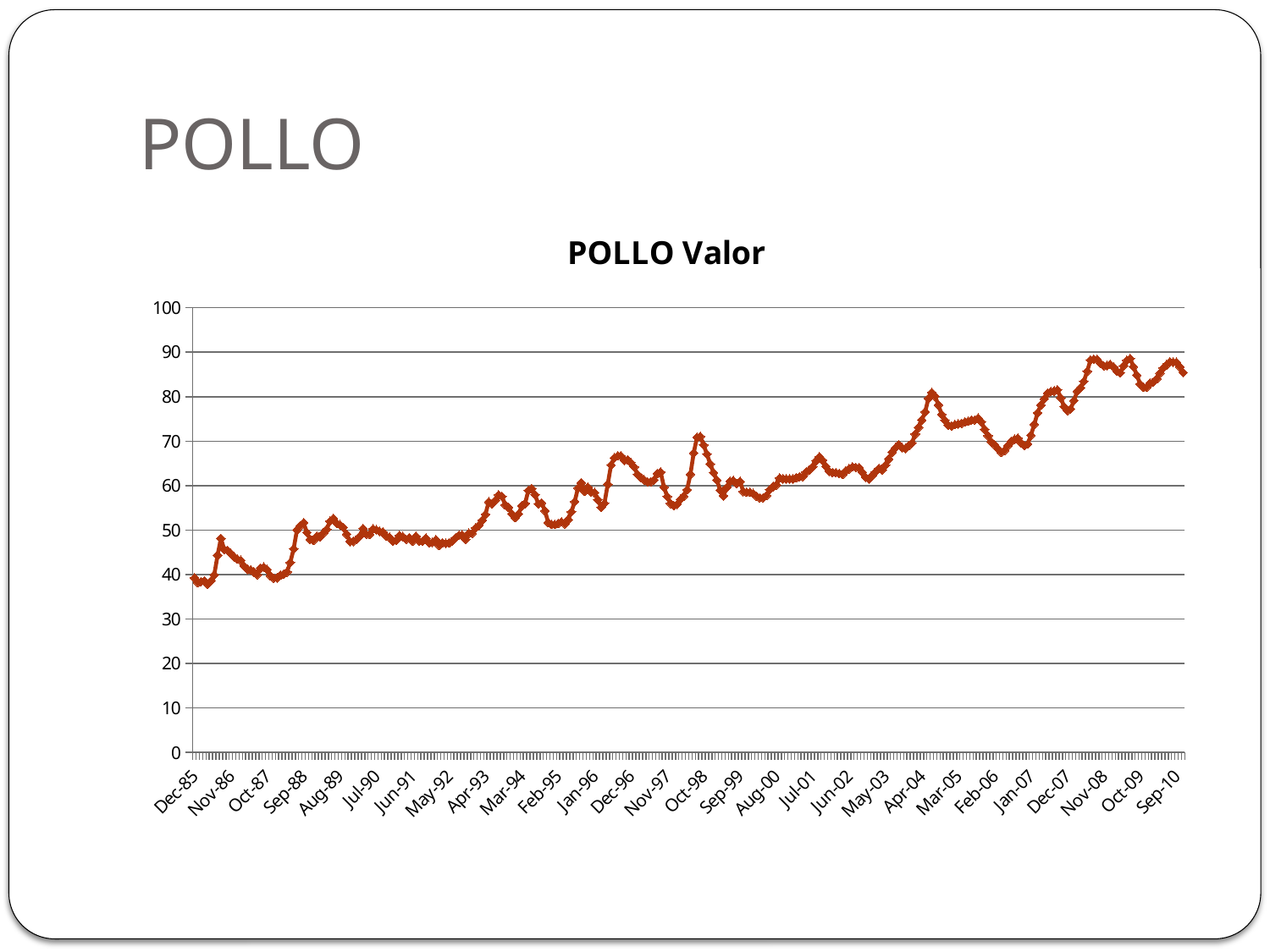
Is the value for Sep-10 greater or less than 80? greater Which is larger, the value for Sep-10 or the value for Dec-85? Sep-10 Is the value for Dec-85 greater or less than 50? less Is the value for Oct-98 greater or less than 60? greater Overall, do the values rise or fall from Dec-85 to Sep-10? rise What is the highest value shown on the vertical axis? 100 Which is larger, the value for Oct-98 or the value for Feb-95? Oct-98 What kind of chart is shown on the slide? line chart What is the title of the chart? POLLO Valor